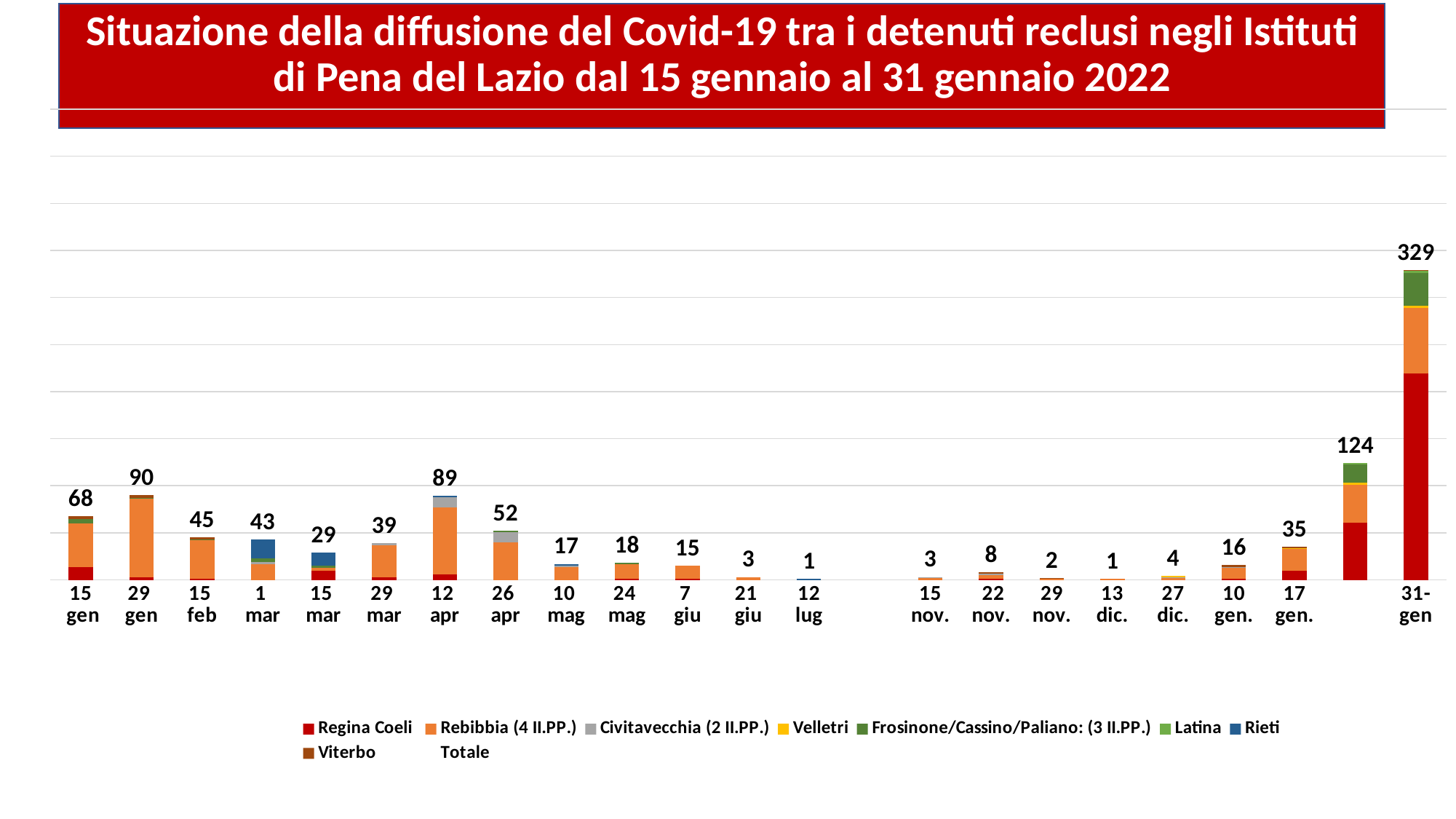
Which date has the highest total? 31-gen What is the difference between the totals for 29 gen and 15 gen? 22 What is the total value shown for 12 apr? 89 What is the total value shown for 22 nov.? 8 What kind of chart is shown on the slide? stacked bar chart What is the difference between the total for 31-gen and the total labelled 124 on the bar just before it? 205 Do the totals rise or fall from 27 dic. to 31-gen? rise What is the total value shown for 31-gen? 329 Which legend entry is shown in red? Regina Coeli What is the total value shown for 29 gen? 90 How many entries does the legend list? 9 Which is larger, the total for 12 apr or the total for 26 apr? 12 apr